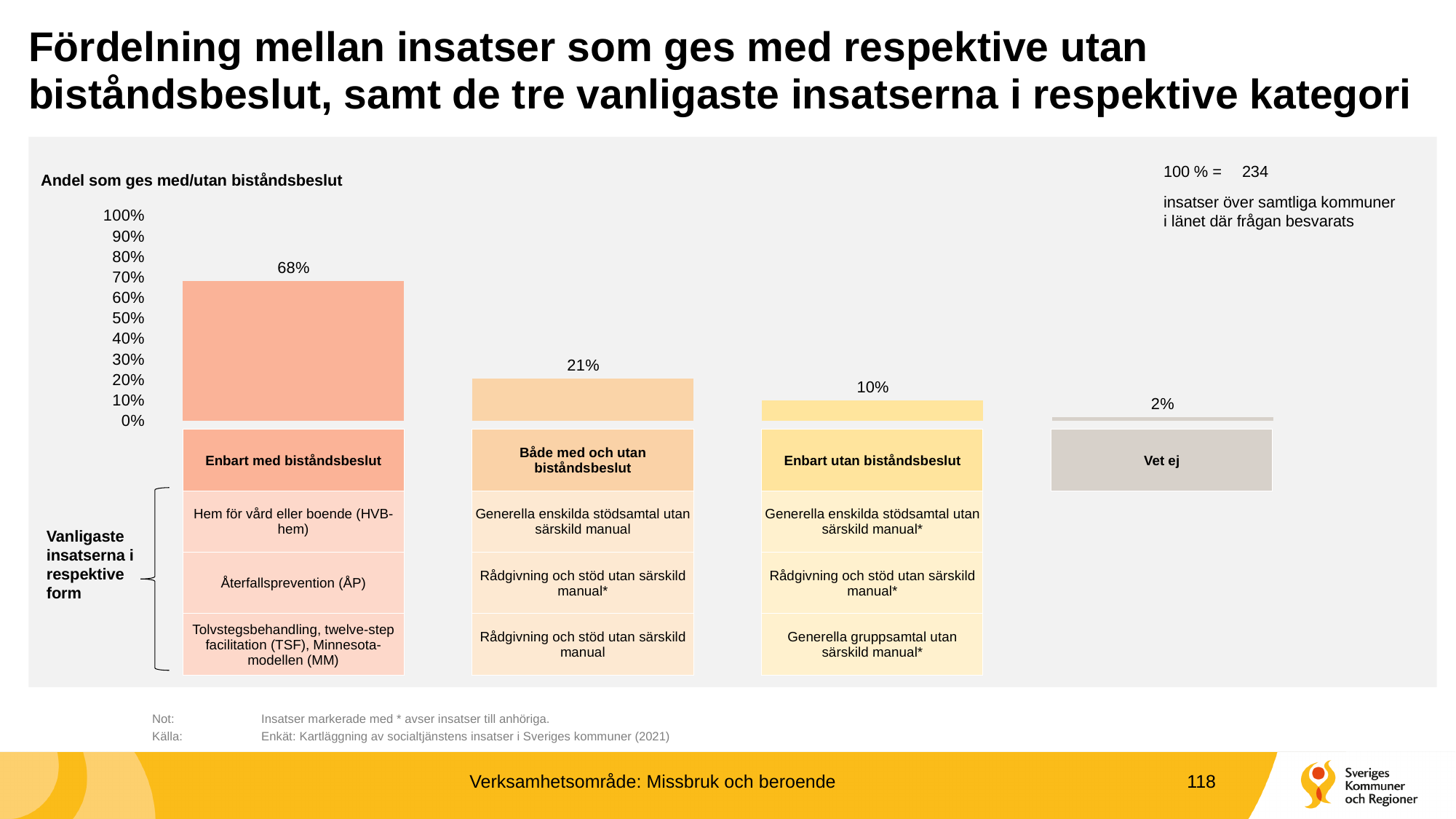
Which is larger, the value for "Enbart utan biståndsbeslut" or the value for "Vet ej"? Enbart utan biståndsbeslut What is the title of the chart? Andel som ges med/utan biståndsbeslut What is the value for "Vet ej"? 2% What is the value for "Enbart utan biståndsbeslut"? 10% What is the difference between the values for "Enbart med biståndsbeslut" and "Både med och utan biståndsbeslut"? 47 percentage points What is the value for "Enbart med biståndsbeslut"? 68% Which category has the highest value? Enbart med biståndsbeslut What is the value for "Både med och utan biståndsbeslut"? 21% How many categories are shown in the bar chart? 4 Which category has the lowest value? Vet ej What kind of chart is shown on the slide? Bar chart Is the value for "Enbart med biståndsbeslut" greater or less than 50%? greater